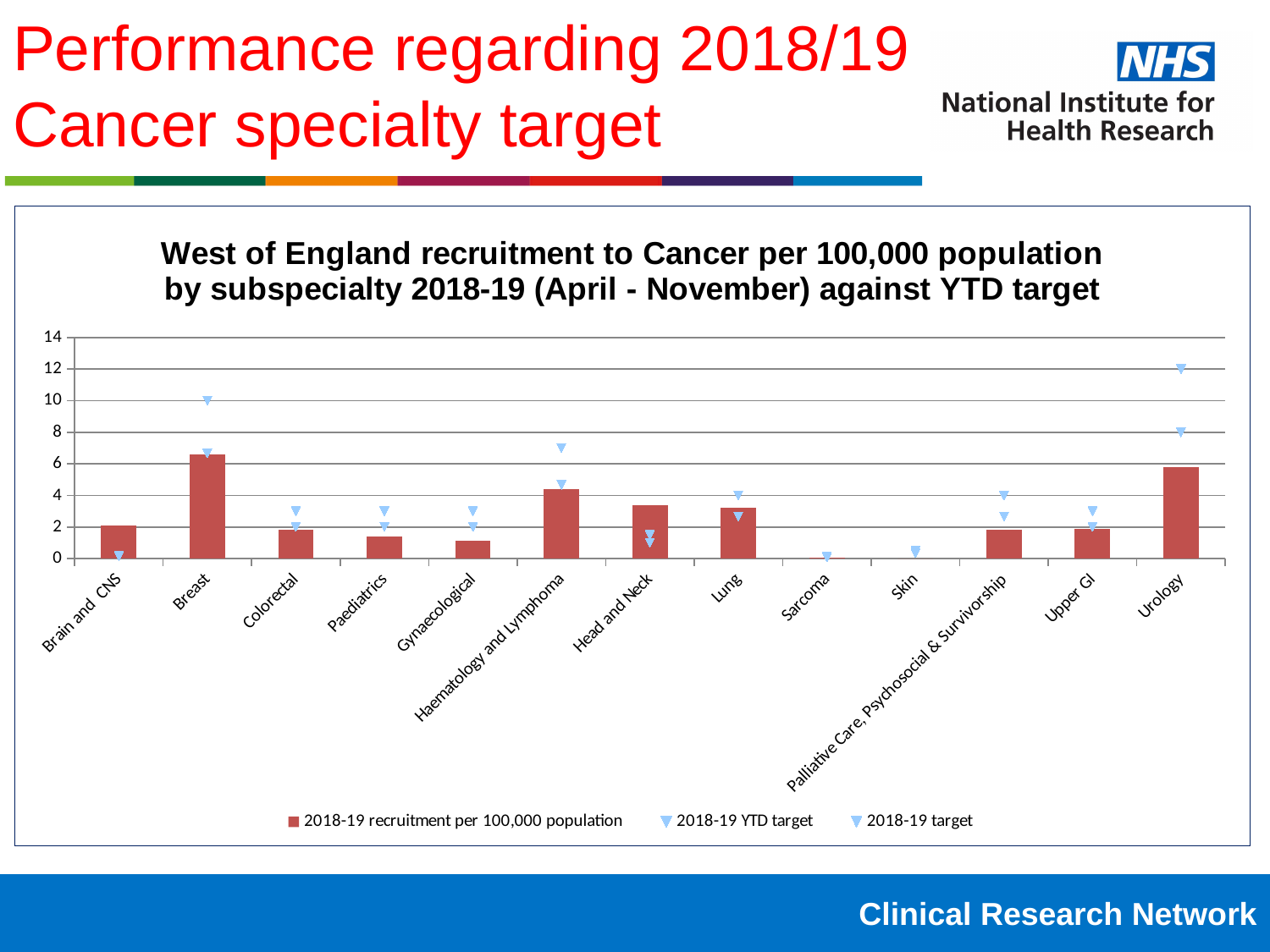
Is the 2018-19 recruitment per 100,000 population for Gynaecological greater or less than 2? less Which is larger, the 2018-19 recruitment per 100,000 population for Breast or for Urology? Breast How many series does the legend list? 3 Is the 2018-19 recruitment per 100,000 population for Breast greater or less than 6? greater How many subspecialty categories are shown on the x axis? 13 What is the title of the chart? West of England recruitment to Cancer per 100,000 population by subspecialty 2018-19 (April - November) against YTD target Which is larger, the 2018-19 recruitment per 100,000 population for Haematology and Lymphoma or for Head and Neck? Haematology and Lymphoma Is the 2018-19 target marker for Urology greater or less than 10? greater What kind of chart is shown on the slide? bar chart What is the first series listed in the chart legend? 2018-19 recruitment per 100,000 population Which subspecialty has the highest 2018-19 recruitment per 100,000 population? Breast